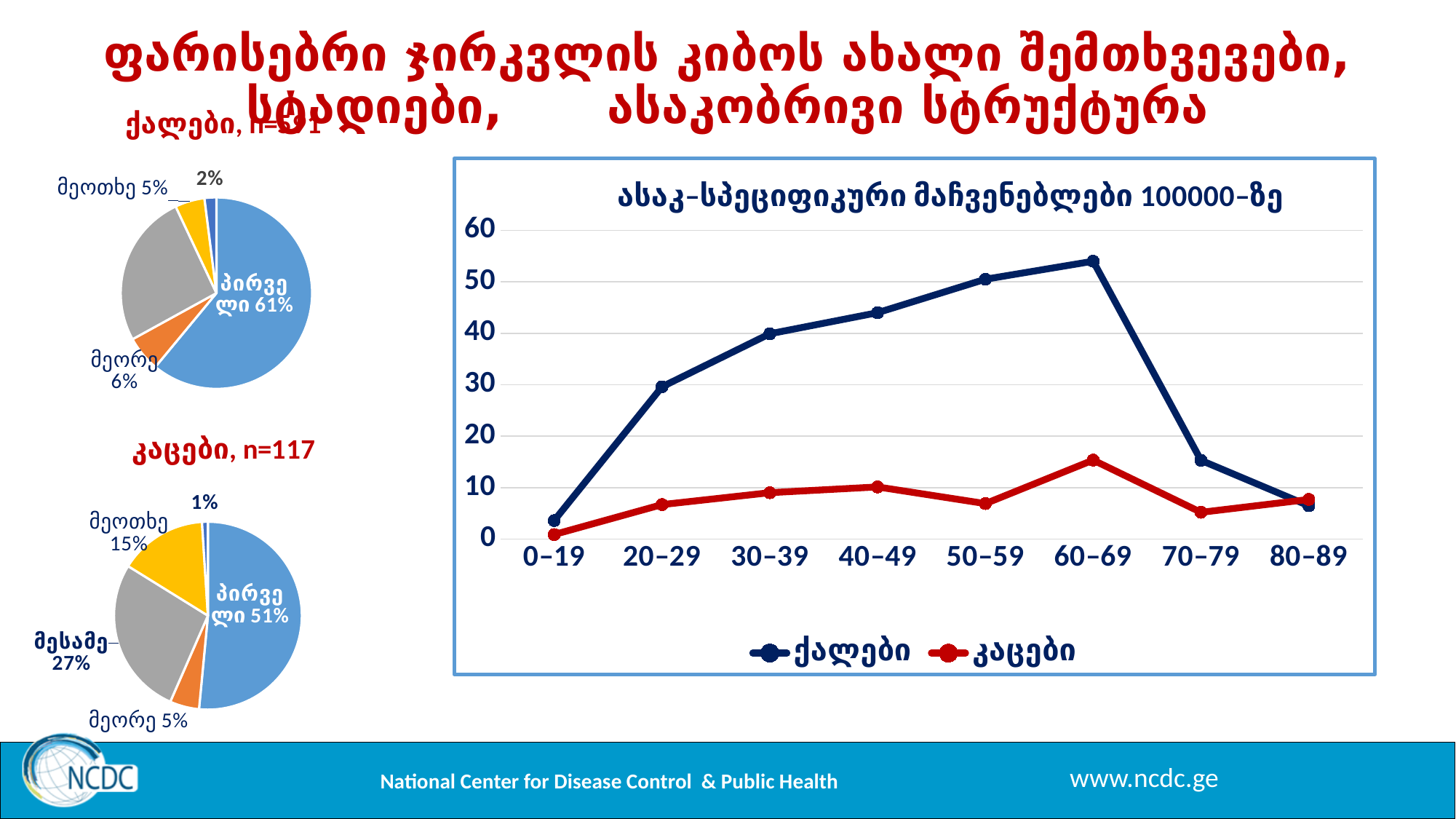
In the chart titled "ასაკ-სპეციფიკური მაჩვენებლები 100000-ზე", is the value for ქალები at 0-19 greater or less than 10? less In the chart titled "ასაკ-სპეციფიკური მაჩვენებლები 100000-ზე", is the value for ქალები at 60-69 greater or less than 50? greater How many age-group categories are shown on the x axis of the chart titled "ასაკ-სპეციფიკური მაჩვენებლები 100000-ზე"? 8 In the top-left pie chart, what share does პირველი have? 61% What kind of chart is the chart titled "ასაკ-სპეციფიკური მაჩვენებლები 100000-ზე"? line chart In the chart titled "ასაკ-სპეციფიკური მაჩვენებლები 100000-ზე", do the values for ქალები rise or fall from 0-19 to 60-69? rise In the pie chart titled "კაცები, n=117", what share does პირველი have? 51% In the pie chart titled "კაცები, n=117", what share does მესამე have? 27% In the chart titled "ასაკ-სპეციფიკური მაჩვენებლები 100000-ზე", is the value for კაცები at 60-69 greater or less than 10? greater How many series does the legend of the chart titled "ასაკ-სპეციფიკური მაჩვენებლები 100000-ზე" list? 2 In the chart titled "ასაკ-სპეციფიკური მაჩვენებლები 100000-ზე", which series has the larger value at 40-49, ქალები or კაცები? ქალები In the chart titled "ასაკ-სპეციფიკური მაჩვენებლები 100000-ზე", which age group has the highest value for ქალები? 60-69